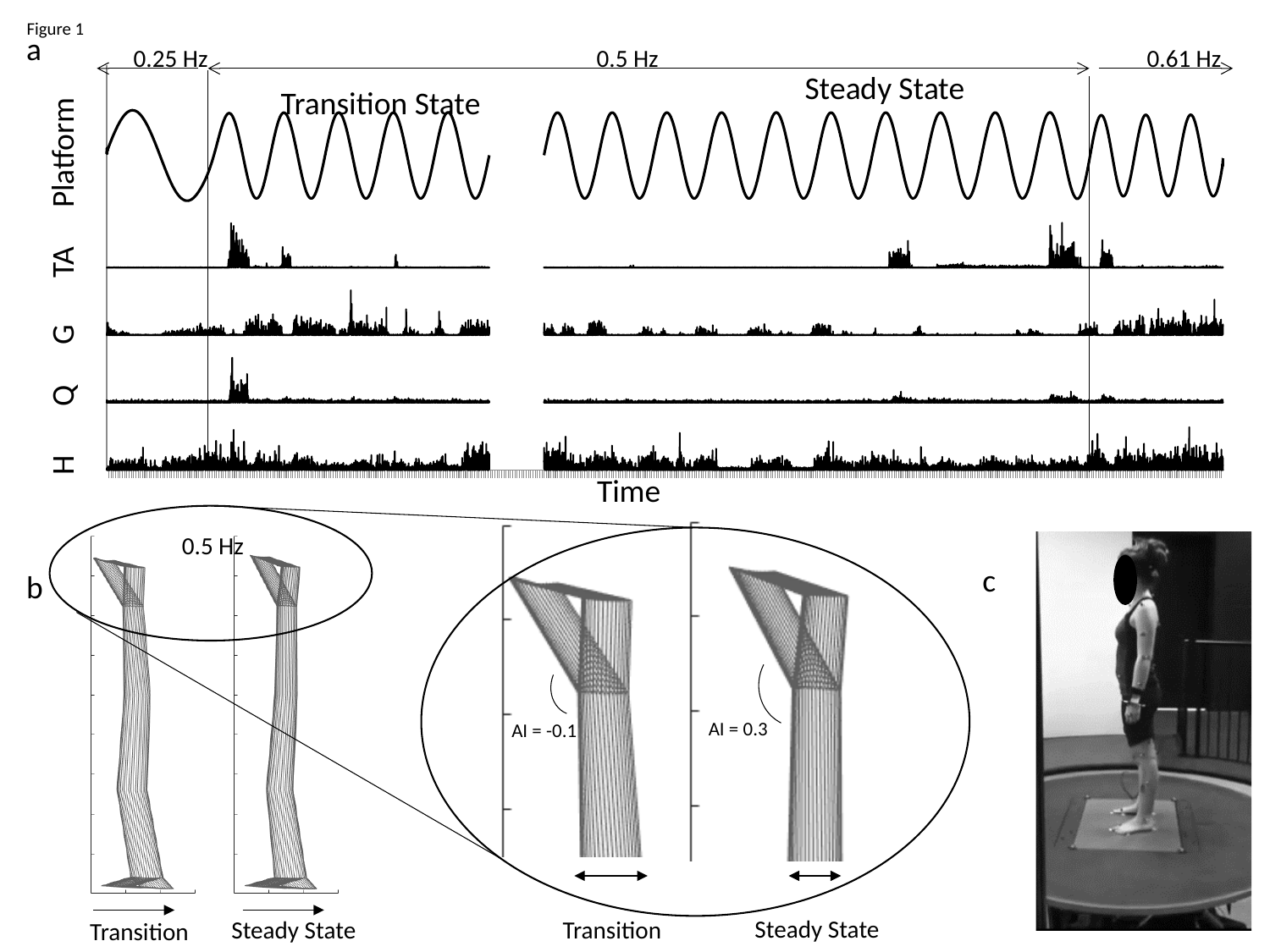
In panel a, what platform frequency is labeled for the leftmost segment? 0.25 Hz In panel b, which condition has the larger AI value, Transition or Steady State? Steady State In panel a, which of the three labeled platform frequencies is the lowest? 0.25 Hz In panel a, what platform frequency is labeled for the rightmost segment? 0.61 Hz In panel a, how many signal traces are stacked vertically (Platform, TA, G, Q, H)? 5 In panel a, how many different platform frequencies are labeled along the top? 3 In panel b, what is the AI value shown for the Transition condition? AI = -0.1 In panel a, what is the label on the horizontal axis? Time In panel b, what is the difference between the Steady State AI value and the Transition AI value? 0.4 In panel a, what platform frequency is labeled for the long middle segment containing the Transition State and Steady State? 0.5 Hz In panel b, what is the AI value shown for the Steady State condition? AI = 0.3 In panel a, which of the three labeled platform frequencies is the highest? 0.61 Hz